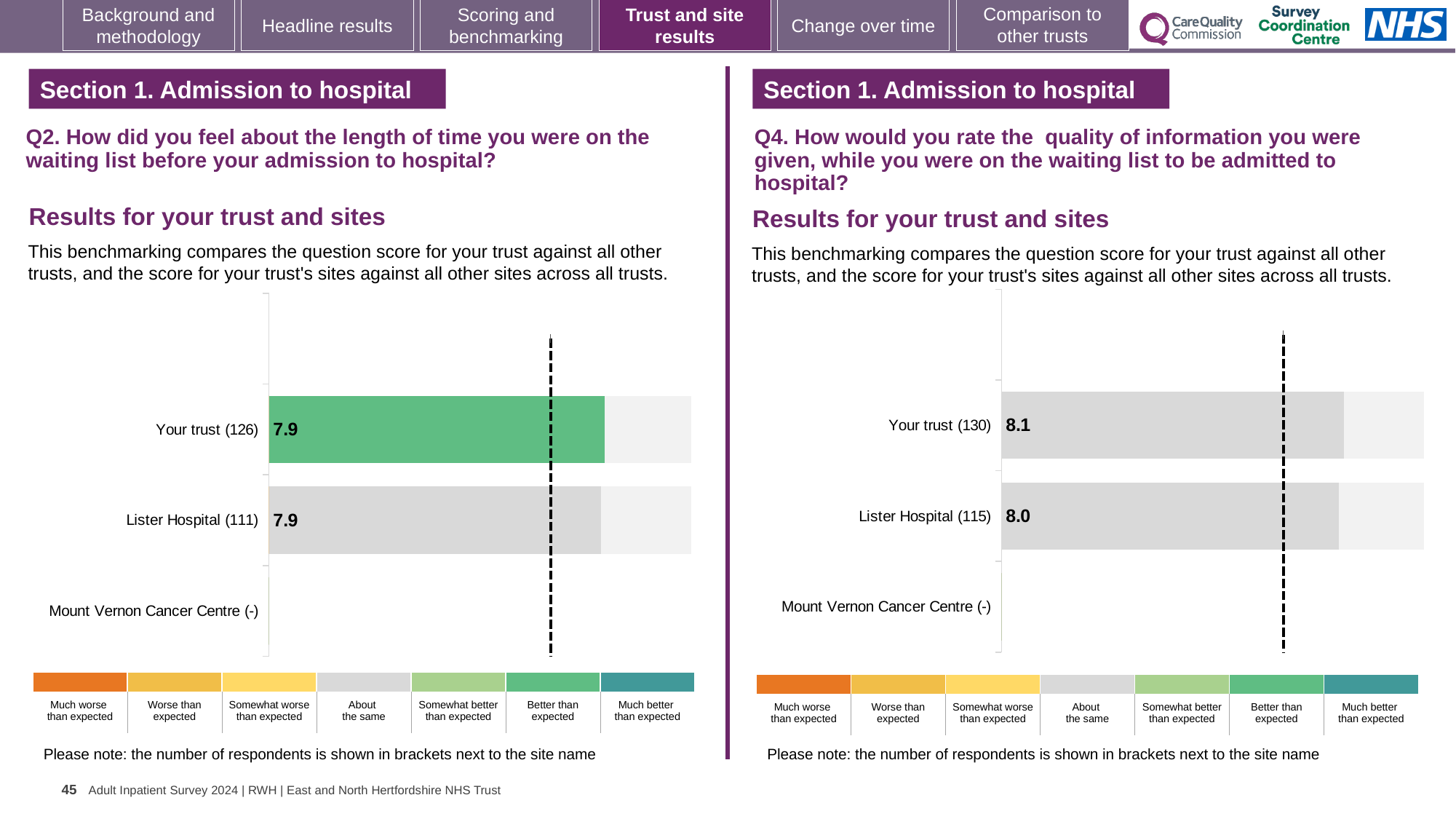
In the Q2 chart on the left, what is the score for Lister Hospital? 7.9 In the Q2 chart on the left, how many respondents are shown in brackets for Your trust? 126 In the Q4 chart on the right, how many respondents are shown in brackets for Lister Hospital? 115 How many categories are listed on the vertical axis of the Q2 chart on the left? 3 How many categories does the colour key below the Q4 chart on the right list? 7 In the Q2 chart on the left, what is the score for Your trust? 7.9 In the Q4 chart on the right, what is the score for Lister Hospital? 8.0 In the Q2 chart on the left, which benchmark category does the green colour of the Your trust bar correspond to in the key? Better than expected In the Q4 chart on the right, which has the higher score, Your trust or Lister Hospital? Your trust In the Q4 chart on the right, what is the score for Your trust? 8.1 In the Q4 chart on the right, what is the difference between the score for Your trust and the score for Lister Hospital? 0.1 What kind of chart is the Q4 chart on the right? Bar chart